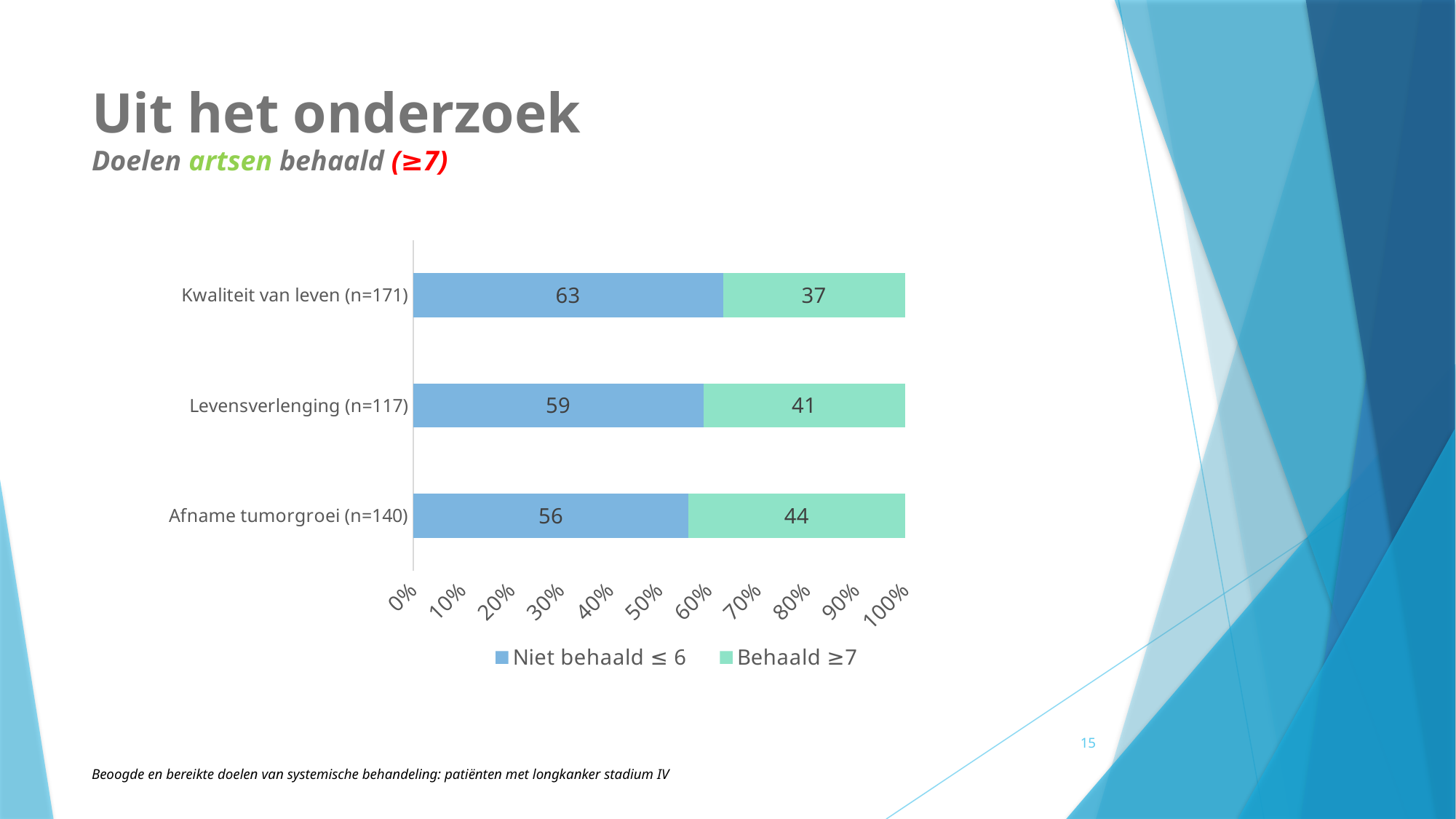
What is the 'Behaald ≥7' value for Afname tumorgroei (n=140)? 44 What is the total of the stacked bar for Levensverlenging (n=117)? 100 Which is larger: the 'Behaald ≥7' value for Levensverlenging (n=117) or for Kwaliteit van leven (n=171)? Levensverlenging (n=117) Which category has the lowest 'Niet behaald ≤ 6' value? Afname tumorgroei (n=140) What is the 'Niet behaald ≤ 6' value for Kwaliteit van leven (n=171)? 63 Which category has the highest 'Behaald ≥7' value? Afname tumorgroei (n=140) What kind of chart is shown on the slide? Stacked bar chart What is the 'Behaald ≥7' value for Levensverlenging (n=117)? 41 What is the difference between the 'Niet behaald ≤ 6' and 'Behaald ≥7' values for Kwaliteit van leven (n=171)? 26 Which colour represents the 'Behaald ≥7' series? Green How many series does the legend list? 2 How many categories are shown on the chart? 3